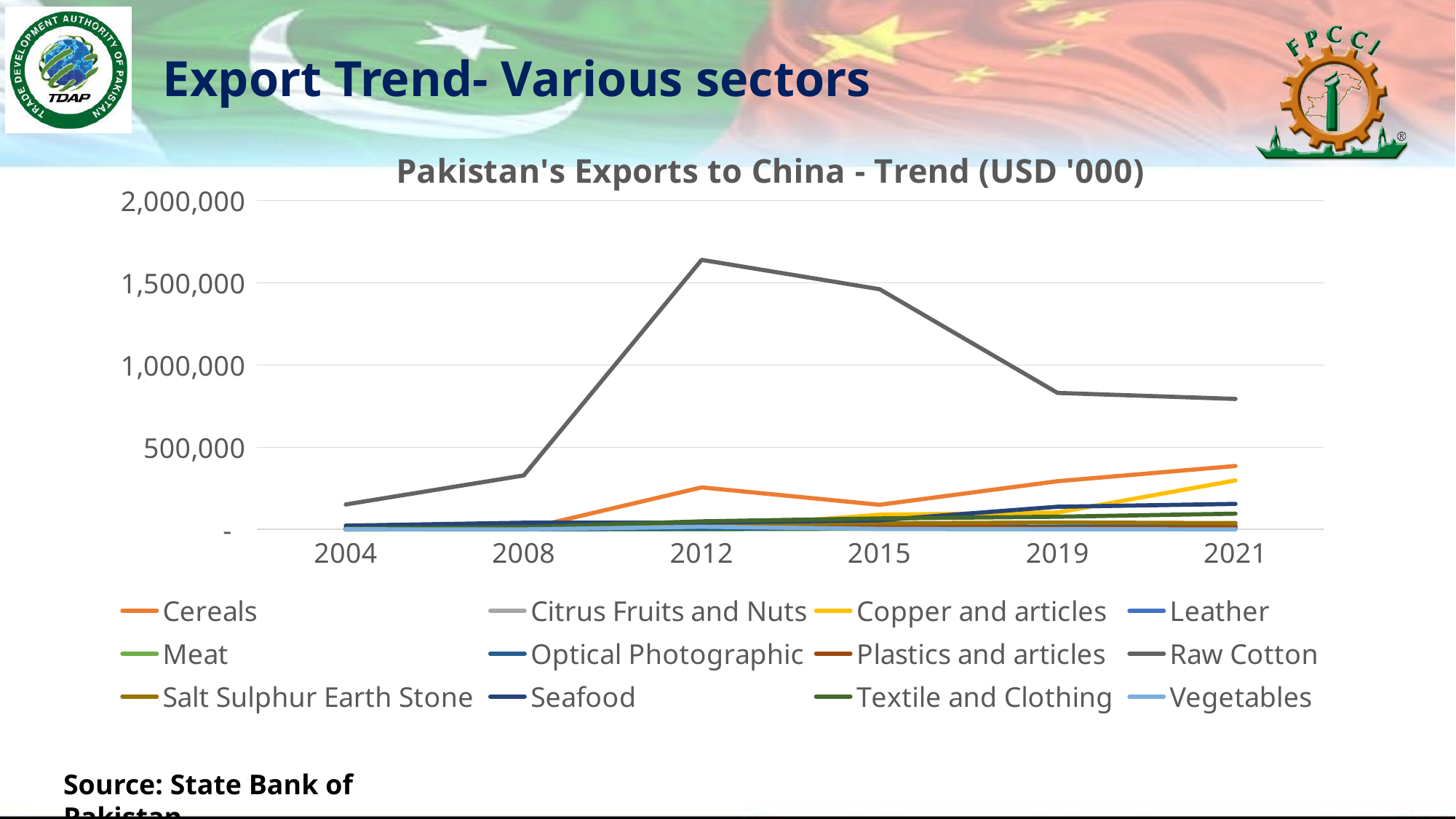
In which year does the Raw Cotton line reach its peak? 2012 Is the value for Cereals in 2021 greater or less than 500,000? less Is the value for Raw Cotton in 2008 greater or less than 500,000? less Is the value for Raw Cotton in 2019 greater or less than 1,000,000? less How many series does the legend list? 12 What kind of chart is shown on the slide? Line chart Which series has the highest value in 2012? Raw Cotton What is the title of the chart? Pakistan's Exports to China - Trend (USD '000) Does the Raw Cotton line rise or fall from 2012 to 2021? Fall Which is larger in 2021, Raw Cotton or Cereals? Raw Cotton How many years are shown on the x axis? 6